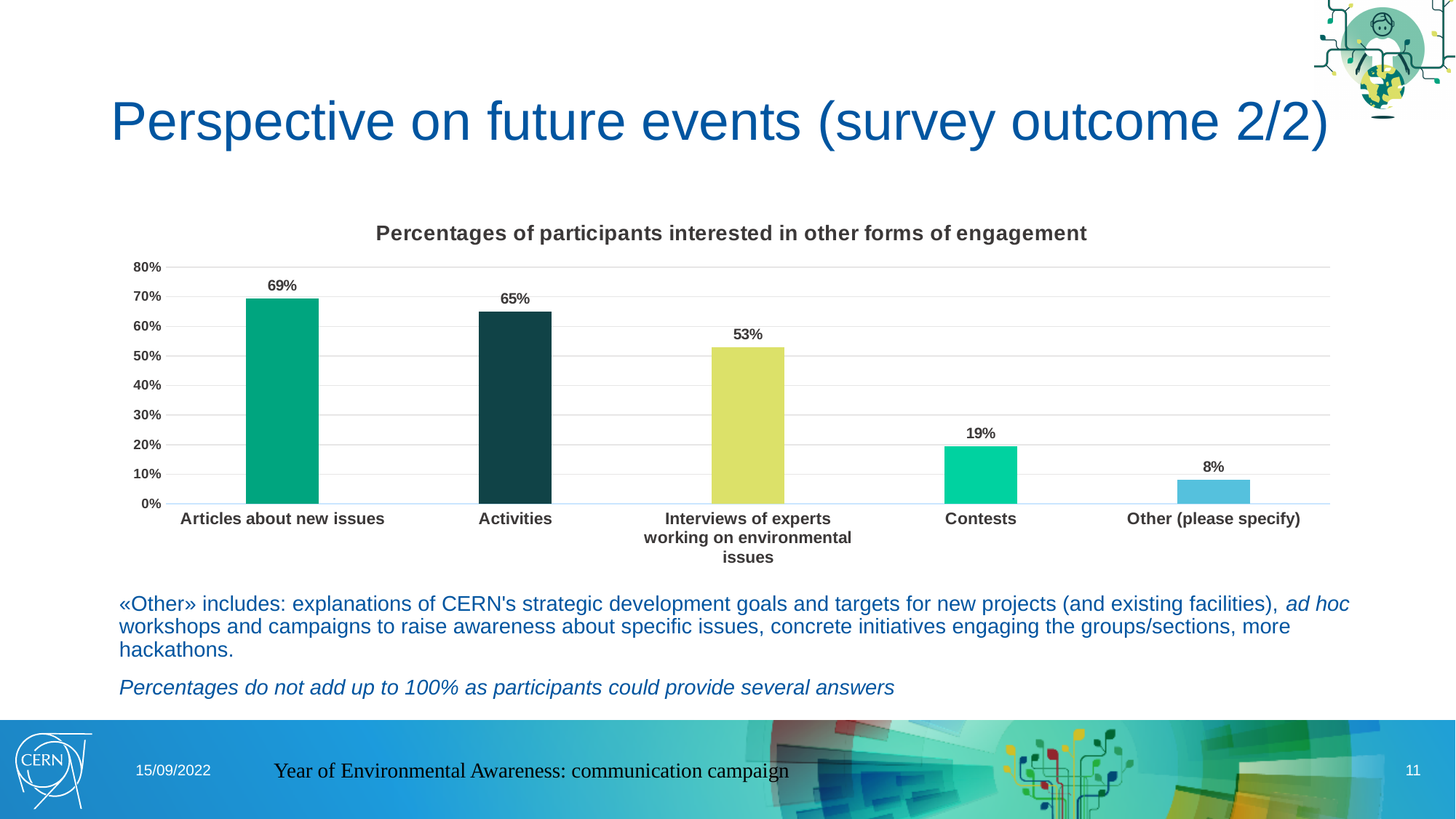
What percentage is shown for Interviews of experts working on environmental issues? 53% How many categories are shown on the x axis of the chart? 5 Which category has the lowest percentage? Other (please specify) What is the value shown for Contests? 19% What is the difference between the percentages for Articles about new issues and Activities? 4% What is the title of the chart? Percentages of participants interested in other forms of engagement Which form of engagement has the highest percentage of interested participants? Articles about new issues Do the values rise or fall from left to right across the categories? Fall What is the difference between the values for Contests and Other (please specify)? 11% What percentage of participants were interested in articles about new issues? 69% What kind of chart is shown on the slide? Bar chart Which has a larger value, Activities or Interviews of experts working on environmental issues? Activities